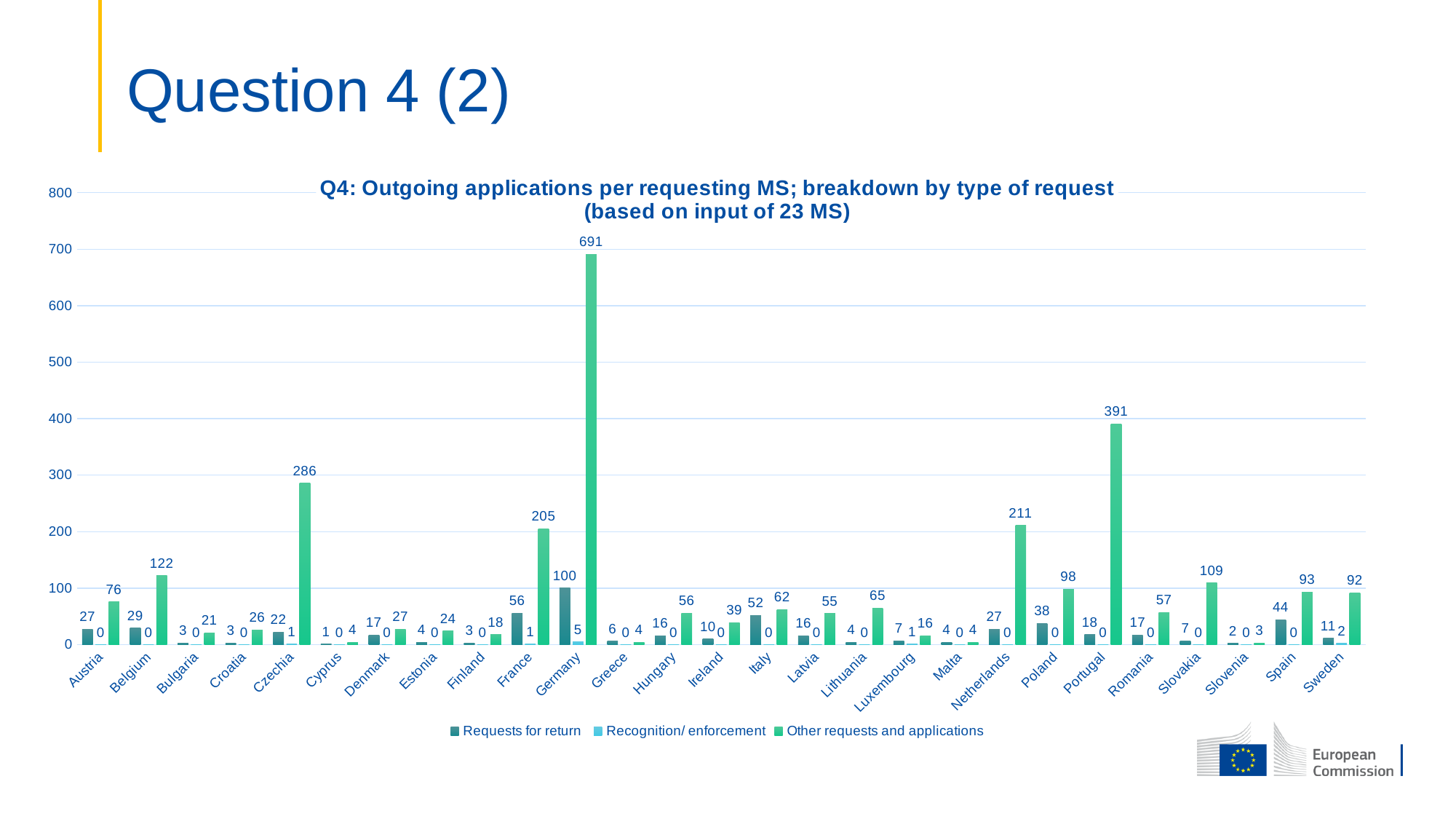
Which is larger: Requests for return for Poland or Requests for return for Spain? Spain Which country has the highest value for Other requests and applications? Germany How many countries are shown on the x axis? 27 What kind of chart is shown on the slide? Bar chart What is the title of the chart? Q4: Outgoing applications per requesting MS; breakdown by type of request (based on input of 23 MS) How many series does the legend list? 3 What is the value of Other requests and applications for Germany? 691 What is the value of Recognition/ enforcement for Sweden? 2 What is the total of the three series for Netherlands? 238 What is the value of Requests for return for Italy? 52 What is the difference between the Other requests and applications values for Portugal and Czechia? 105 Which country has the highest value for Requests for return? Germany